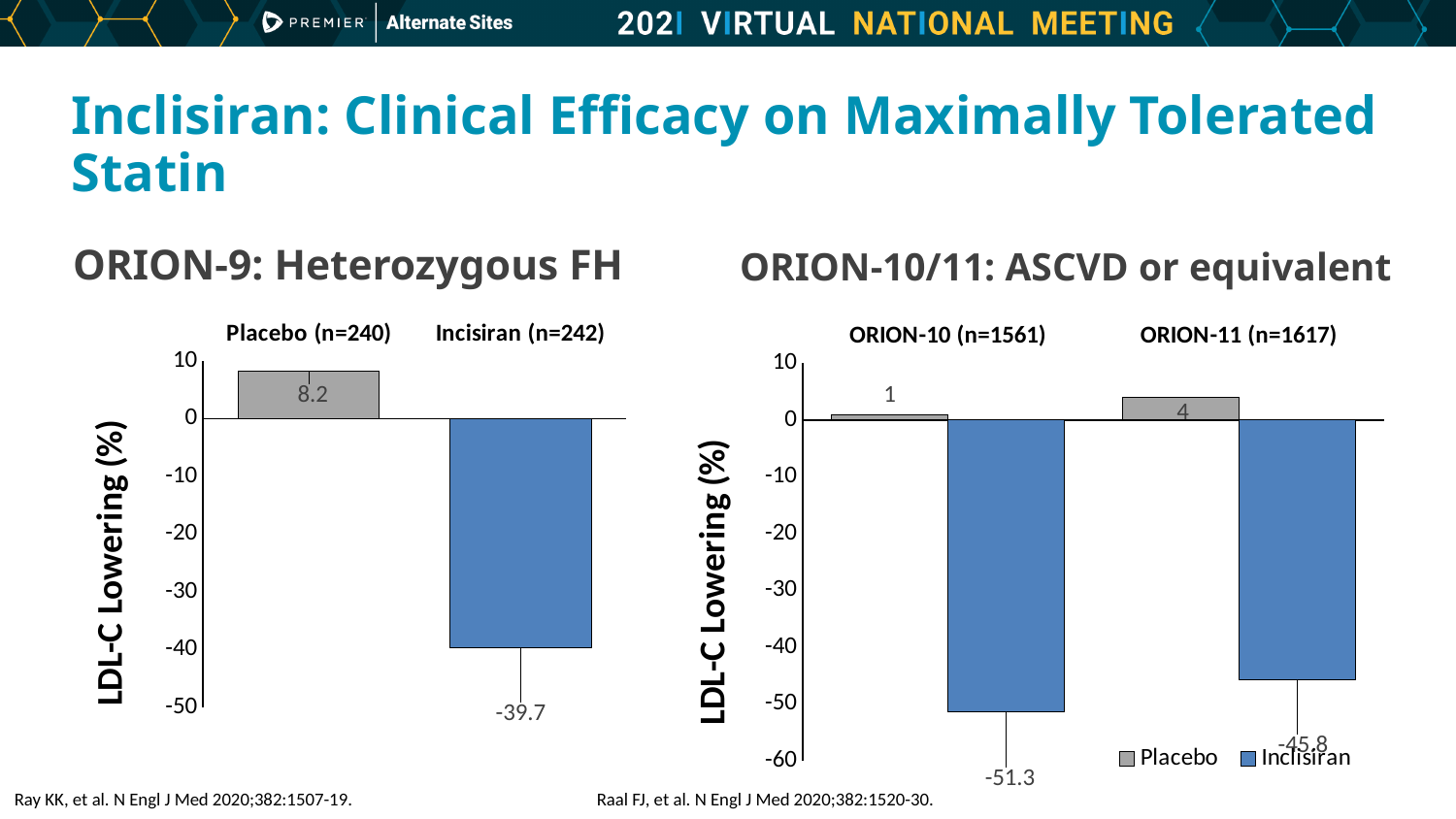
In the ORION-10/11: ASCVD or equivalent chart, how many series does the legend list? 2 In the ORION-9: Heterozygous FH chart, what is the LDL-C lowering value for Incisiran (n=242)? -39.7 What type of chart is the ORION-9: Heterozygous FH chart? Bar chart What is the y-axis label of the ORION-9: Heterozygous FH chart? LDL-C Lowering (%) In the ORION-10/11: ASCVD or equivalent chart, what is the difference between the Placebo values for ORION-11 (n=1617) and ORION-10 (n=1561)? 3 In the ORION-9: Heterozygous FH chart, what is the difference between the Placebo (n=240) value and the Incisiran (n=242) value? 47.9 In the ORION-10/11: ASCVD or equivalent chart, what is the Inclisiran value for ORION-11 (n=1617)? -45.8 In the ORION-10/11: ASCVD or equivalent chart, what is the Inclisiran value for ORION-10 (n=1561)? -51.3 In the ORION-10/11: ASCVD or equivalent chart, what is the Placebo value for ORION-10 (n=1561)? 1 In the ORION-9: Heterozygous FH chart, what is the LDL-C lowering value for Placebo (n=240)? 8.2 In the ORION-10/11: ASCVD or equivalent chart, what is the Placebo value for ORION-11 (n=1617)? 4 In the ORION-10/11: ASCVD or equivalent chart, which study has the lower Inclisiran value, ORION-10 (n=1561) or ORION-11 (n=1617)? ORION-10 (n=1561)